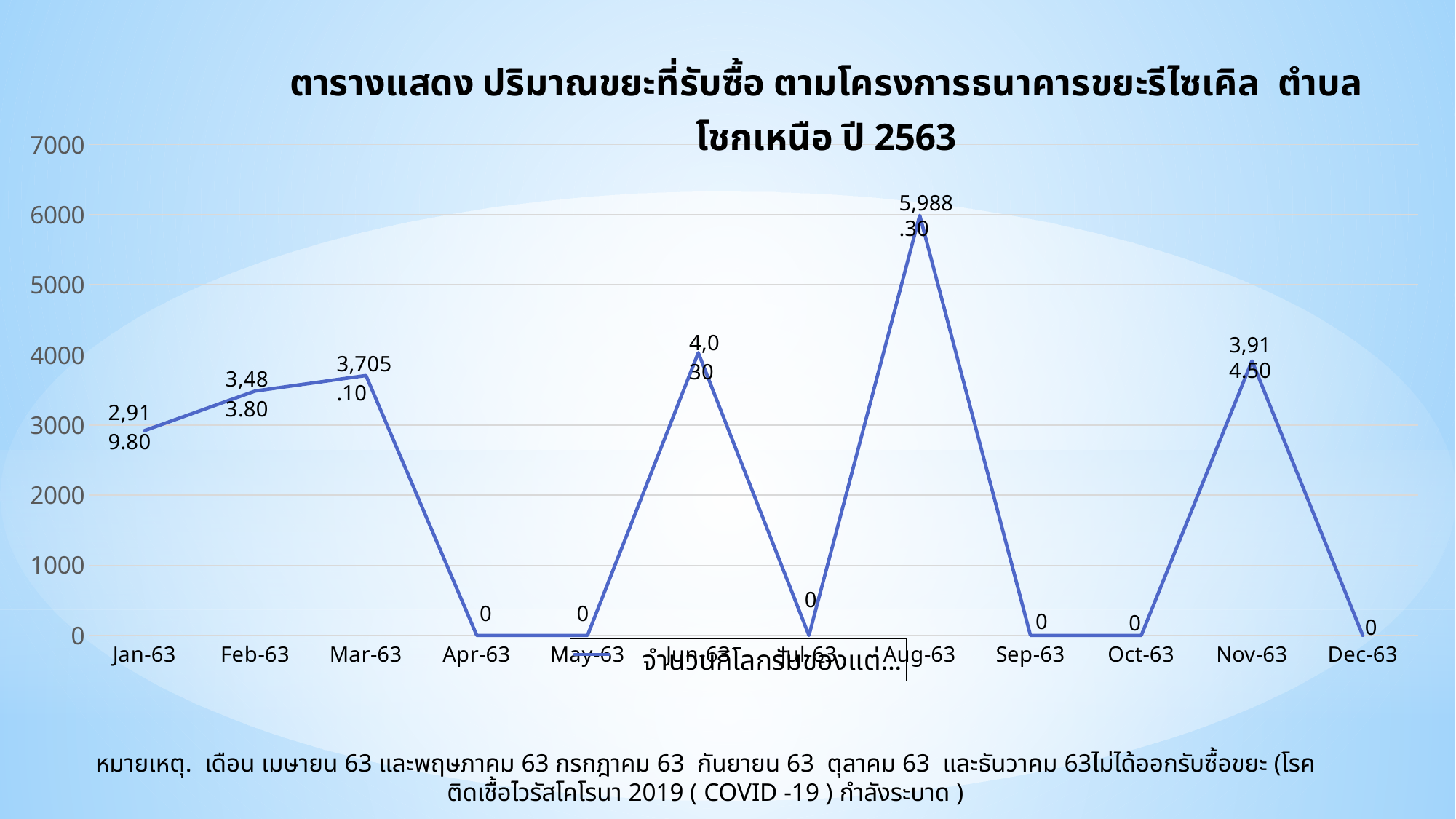
Which is larger, the value for Jun-63 or the value for Mar-63? Jun-63 Do the values rise or fall from Jan-63 to Mar-63? rise How many months have a value of 0? 6 What is the value for Mar-63? 3,705.10 What type of chart is shown on the slide? line chart What is the value for Nov-63? 3,914.50 What is the value for Aug-63? 5,988.30 Is the value for Aug-63 greater or less than 5000? greater Which month has the highest value? Aug-63 How many months are plotted along the x axis? 12 What is the value for Apr-63? 0 What is the difference between the values for Aug-63 and Mar-63? 2,283.20